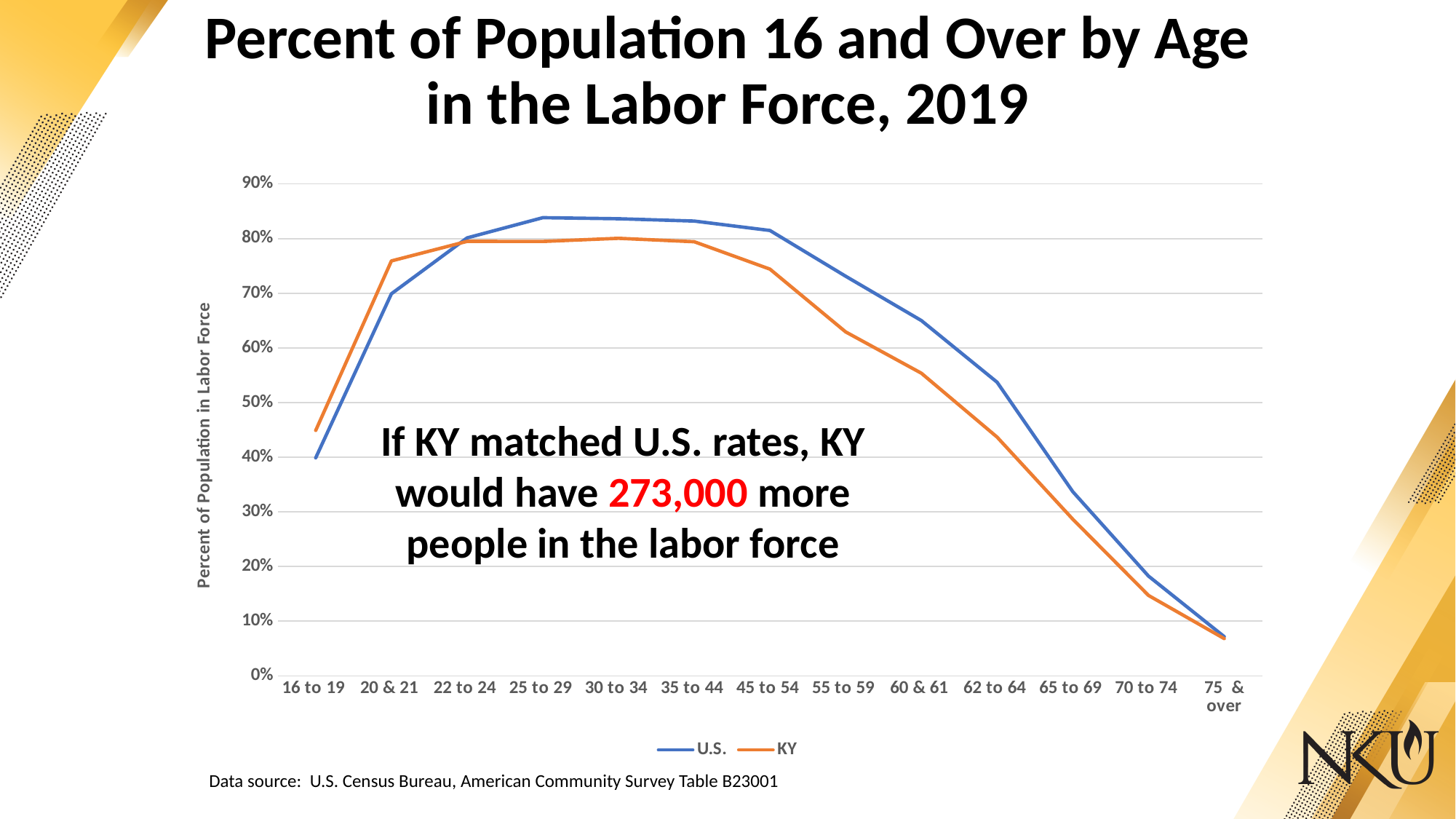
Which age group has the lowest value for the KY series? 75 & over For the 45 to 54 age group, which series has the higher value, U.S. or KY? U.S. How many age categories are shown on the x axis? 13 For the 20 & 21 age group, which series has the higher value, U.S. or KY? KY What kind of chart is shown on the slide? line chart Is the KY value for 62 to 64 greater or less than 50%? less How many series does the legend list? 2 Is the KY value for 16 to 19 greater or less than 40%? greater Is the KY value for 70 to 74 greater or less than 20%? less Do the values for the U.S. series rise or fall from 45 to 54 through 75 & over? fall